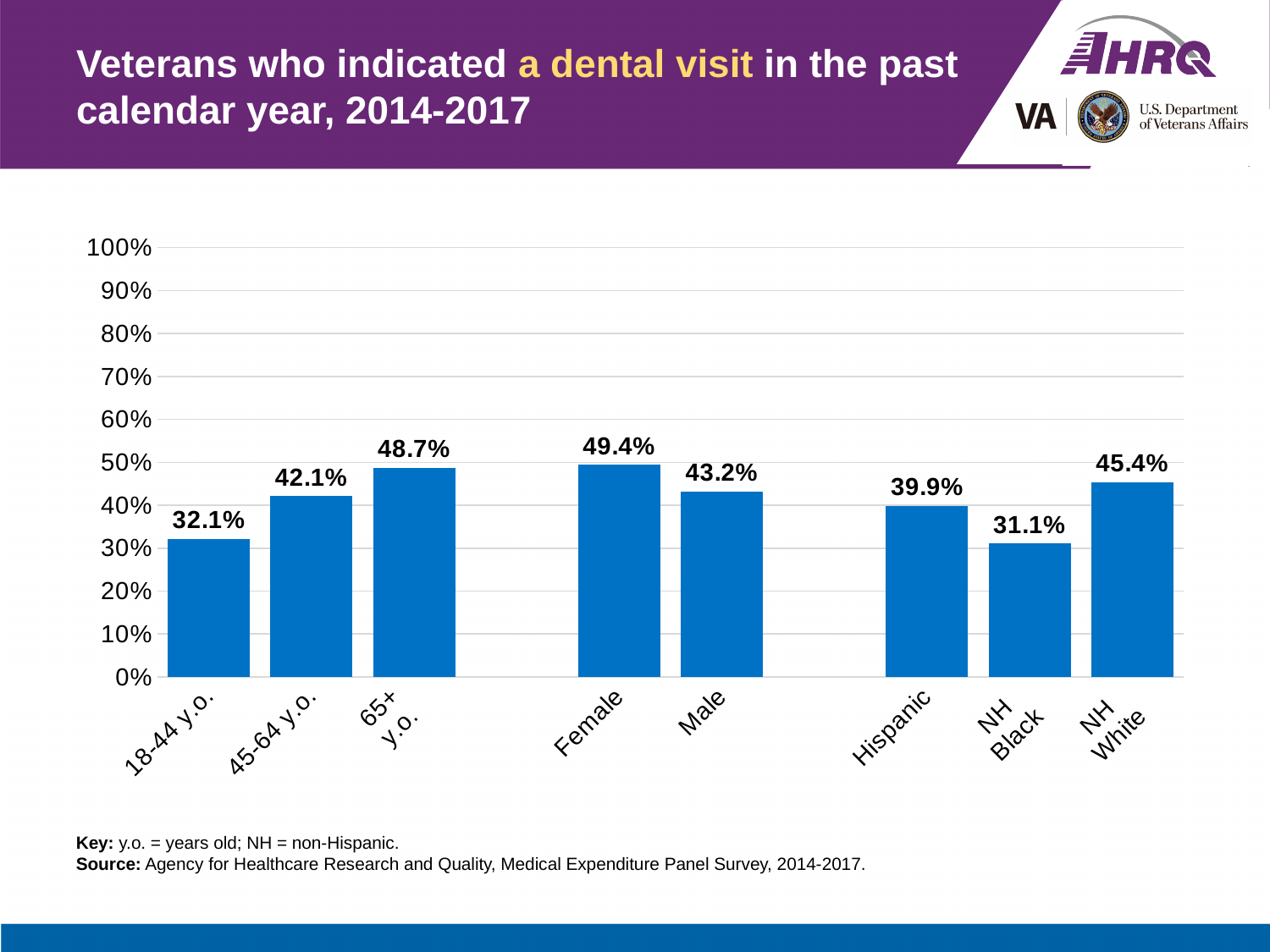
What percentage of veterans aged 18-44 y.o. indicated a dental visit in the past calendar year? 32.1% What is the value shown for NH Black veterans? 31.1% Which category has the highest value on the chart? Female Which is larger, the value for Hispanic veterans or the value for NH White veterans? NH White Do the values rise or fall across the three age groups from 18-44 y.o. to 65+ y.o.? rise Is the value for 45-64 y.o. veterans greater or less than 50%? less What kind of chart is shown on the slide? bar chart What is the difference between the values for Female and Male veterans? 6.2% Which category has the lowest value on the chart? NH Black What is the value shown for Female veterans? 49.4% How many categories are shown on the x axis of the chart? 8 What is the difference between the values for 65+ y.o. and 18-44 y.o. veterans? 16.6%